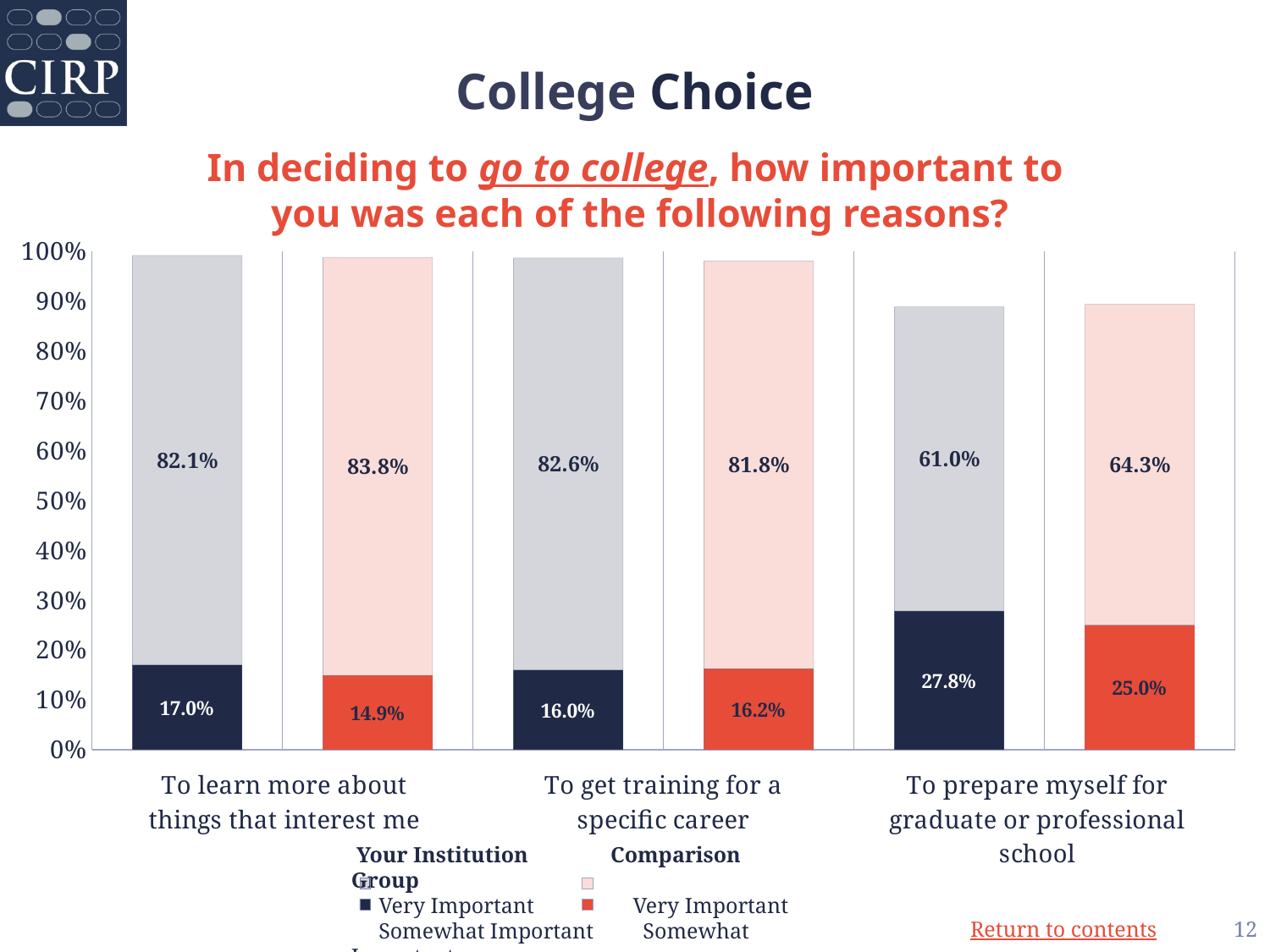
Is the total height of the Comparison Group bar for 'To get training for a specific career' greater or less than 90%? greater For 'To learn more about things that interest me', which is larger: the Your Institution Very Important value or the Comparison Group Very Important value? Your Institution (17.0%) Which colour represents the Comparison Group's Very Important responses? Orange-red What kind of chart is shown on the slide? Stacked bar chart How many reasons (categories) are shown along the x axis? 3 What percentage of Your Institution students rated 'To learn more about things that interest me' as Very Important? 17.0% Which reason has the highest Very Important percentage for Your Institution? To prepare myself for graduate or professional school What is the combined total (Very Important plus Somewhat Important) of the Your Institution bar for 'To prepare myself for graduate or professional school'? 88.8% What is the difference between the Your Institution and Comparison Group Very Important values for 'To prepare myself for graduate or professional school'? 2.8% What is the Very Important value for the Comparison Group for 'To get training for a specific career'? 16.2% Which reason has the lowest Somewhat Important percentage for the Comparison Group? To prepare myself for graduate or professional school What percentage of the Comparison Group rated 'To prepare myself for graduate or professional school' as Somewhat Important? 64.3%